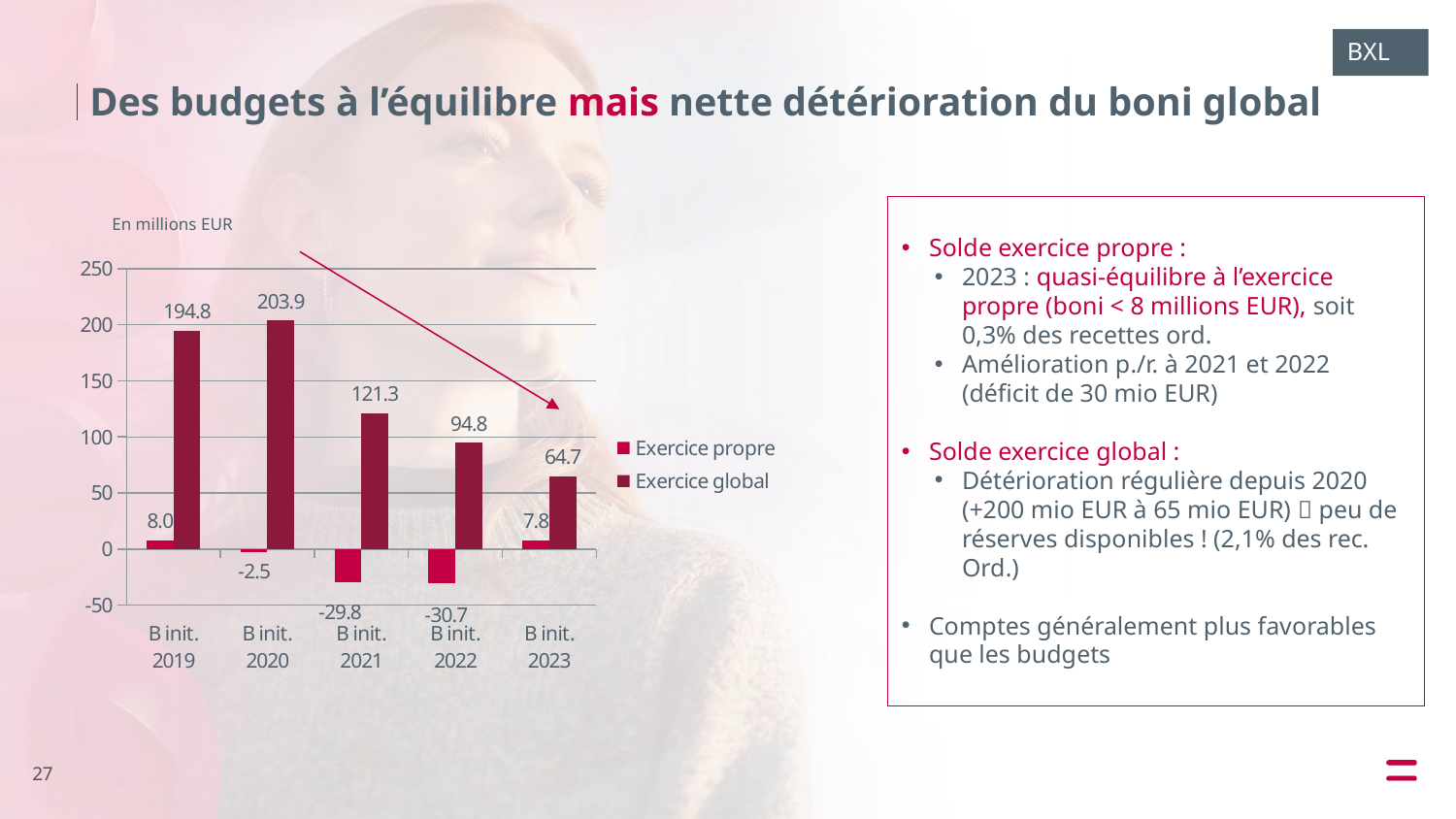
How many series does the legend list? 2 What is the difference between the Exercice global values for B init. 2020 and B init. 2023? 139.2 Which year has the highest Exercice global value? B init. 2020 What unit is indicated above the chart? En millions EUR Which is larger, the Exercice propre value for B init. 2019 or for B init. 2023? B init. 2019 What kind of chart is shown on the slide? Bar chart What is the value of Exercice global for B init. 2019? 194.8 Does the Exercice global series rise or fall from B init. 2020 to B init. 2023? Fall Which year has the lowest Exercice propre value? B init. 2022 What is the value of Exercice propre for B init. 2022? -30.7 How many years are shown on the x axis? 5 What is the value of Exercice global for B init. 2023? 64.7